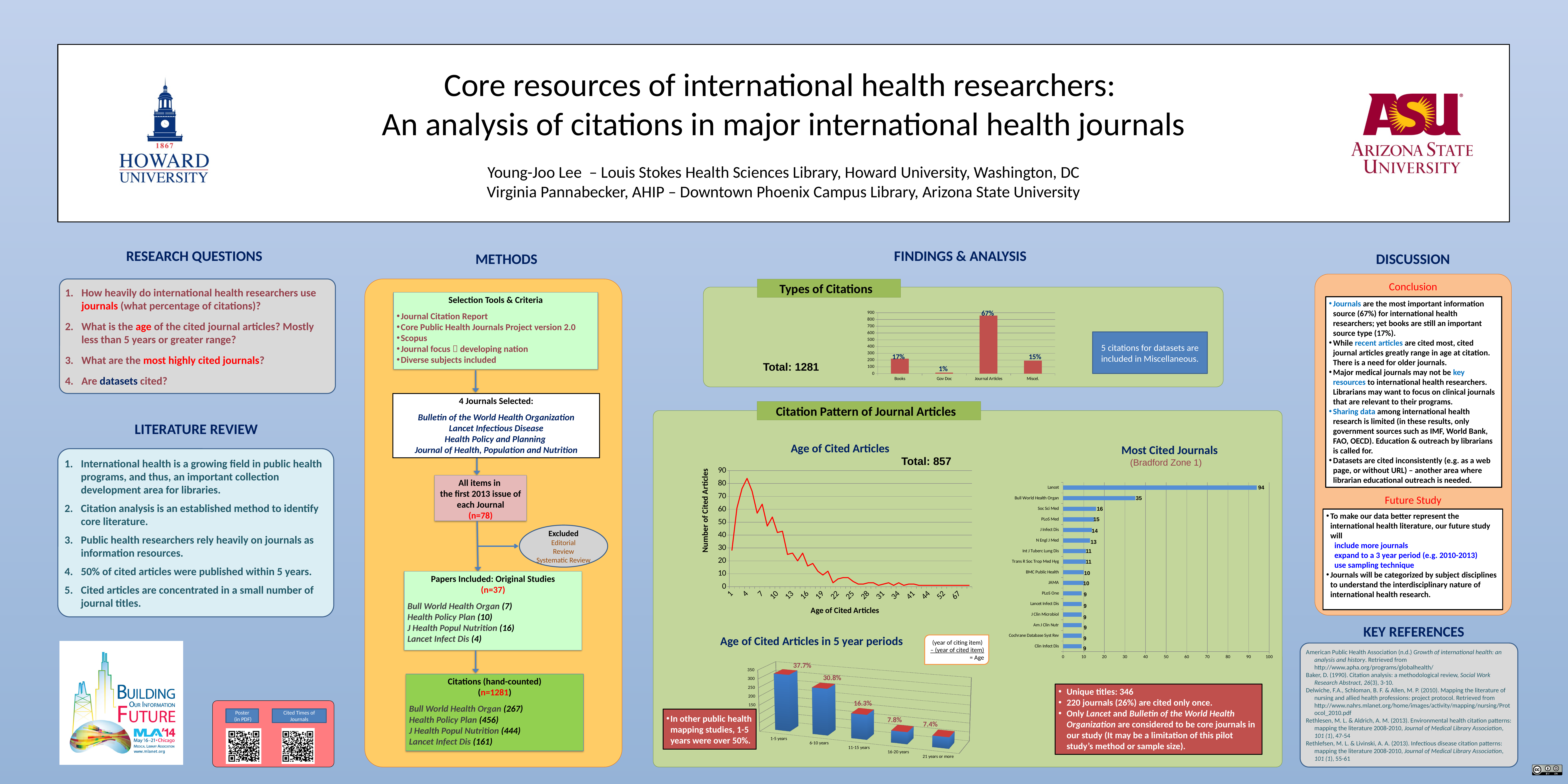
In the 'Most Cited Journals' chart, what is the difference between Lancet and Bull World Health Organ? 59 What kind of chart is the 'Age of Cited Articles' chart? line chart In the 'Age of Cited Articles in 5 year periods' chart, which period has the lowest percentage? 21 years or more In the 'Types of Citations' chart, what percentage is shown for Journal Articles? 67% In the 'Age of Cited Articles in 5 year periods' chart, what percentage is shown for 6-10 years? 30.8% In the 'Types of Citations' chart, what is the difference in percentage points between Books and Miscel.? 2 In the 'Types of Citations' chart, which category has the lowest value? Gov Doc In the 'Most Cited Journals' chart, which journal has the second-highest number of citations? Bull World Health Organ In the 'Age of Cited Articles in 5 year periods' chart, do the values rise or fall as the age period increases? fall In the 'Types of Citations' chart, how many categories are shown on the x axis? 4 In the 'Most Cited Journals' chart, how many journals are listed? 16 In the 'Most Cited Journals' chart, how many citations does Lancet have? 94